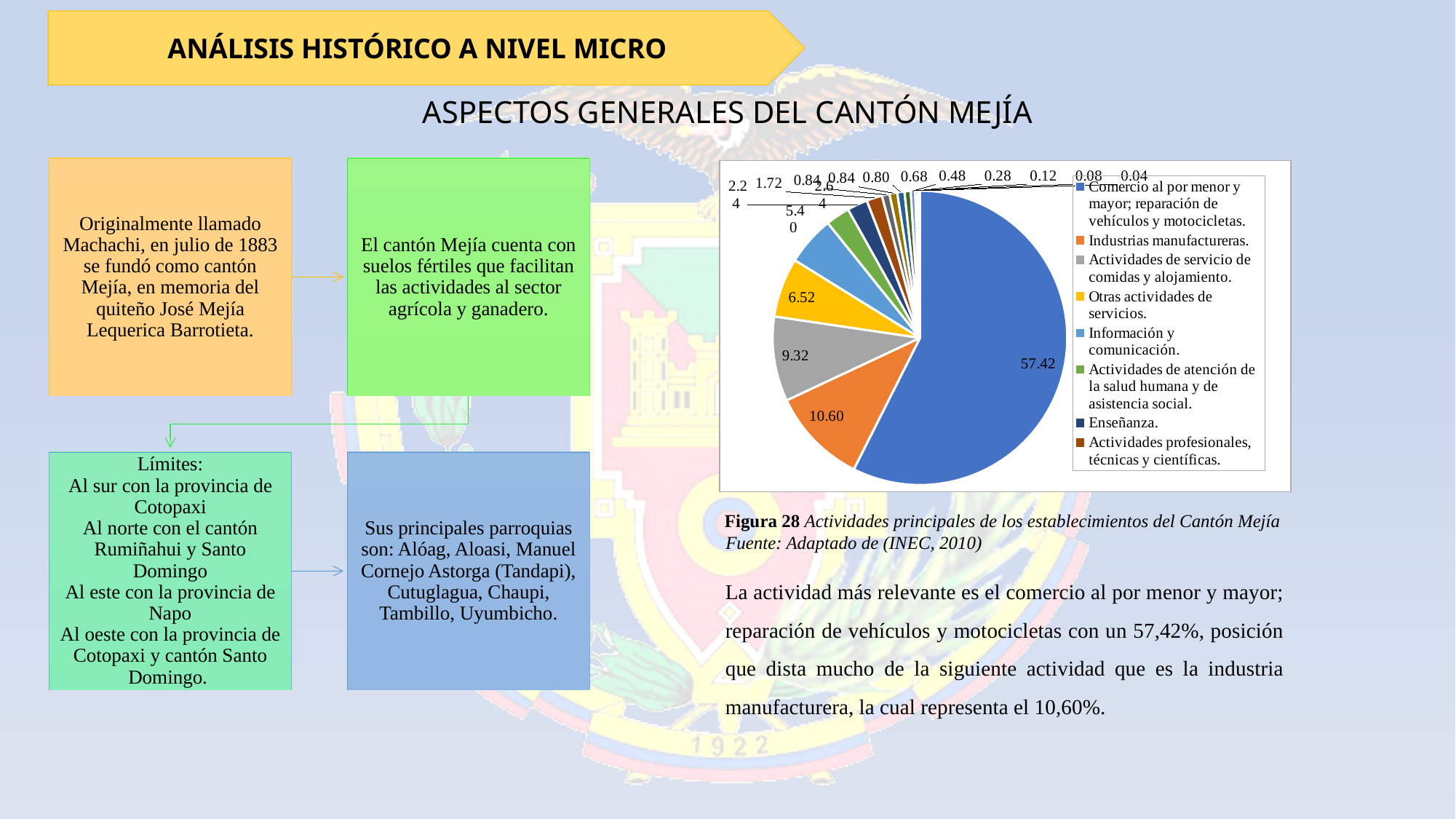
What is the value for 'Comercio al por menor y mayor; reparación de vehículos y motocicletas' in the pie chart? 57.42 What is the figure number given in the caption below the pie chart? Figura 28 What is the value for 'Otras actividades de servicios' in the pie chart? 6.52 What is the value for 'Información y comunicación' in the pie chart? 5.40 What is the difference between the values for 'Comercio al por menor y mayor; reparación de vehículos y motocicletas' and 'Industrias manufactureras'? 46.82 What is the value for 'Industrias manufactureras' in the pie chart? 10.60 Which is larger in the pie chart: 'Actividades de servicio de comidas y alojamiento' or 'Otras actividades de servicios'? Actividades de servicio de comidas y alojamiento What colour is the slice for 'Industrias manufactureras' in the pie chart? orange What is the value for 'Actividades de servicio de comidas y alojamiento' in the pie chart? 9.32 Which category has the largest slice in the pie chart? Comercio al por menor y mayor; reparación de vehículos y motocicletas What kind of chart is shown on the slide? pie chart What is the difference between the values for 'Actividades de servicio de comidas y alojamiento' and 'Otras actividades de servicios'? 2.80